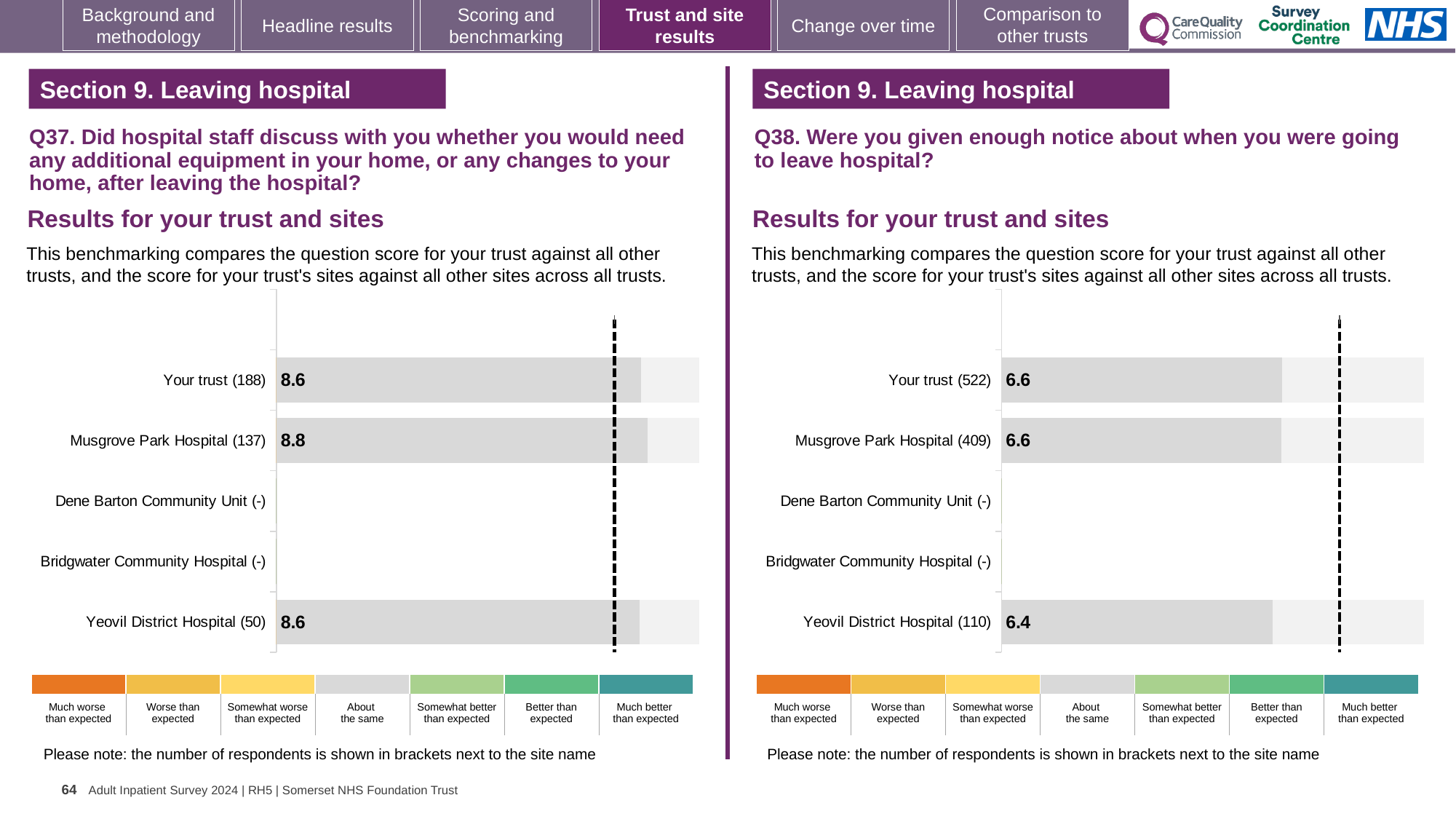
In the Q38 chart on the right, what is the difference between the scores for Your trust and Yeovil District Hospital? 0.2 In the Q37 chart on the left, what is the score for Musgrove Park Hospital? 8.8 In the Q38 chart on the right, what is the score for Your trust? 6.6 In the Q37 chart on the left, which site has the highest score? Musgrove Park Hospital What type of chart is used in the Q38 chart on the right? Bar chart In the Q37 chart on the left, what is the difference between the scores for Musgrove Park Hospital and Yeovil District Hospital? 0.2 In the Q37 chart on the left, what is the score for Yeovil District Hospital? 8.6 In the Q37 chart on the left, what is the score for Your trust? 8.6 In the Q38 chart on the right, which is larger: the score for Musgrove Park Hospital or the score for Yeovil District Hospital? Musgrove Park Hospital In the Q38 chart on the right, which site has the lowest score among those with a score shown? Yeovil District Hospital How many site rows (including Your trust) are listed in the Q37 chart on the left? 5 In the Q38 chart on the right, what is the score for Yeovil District Hospital? 6.4